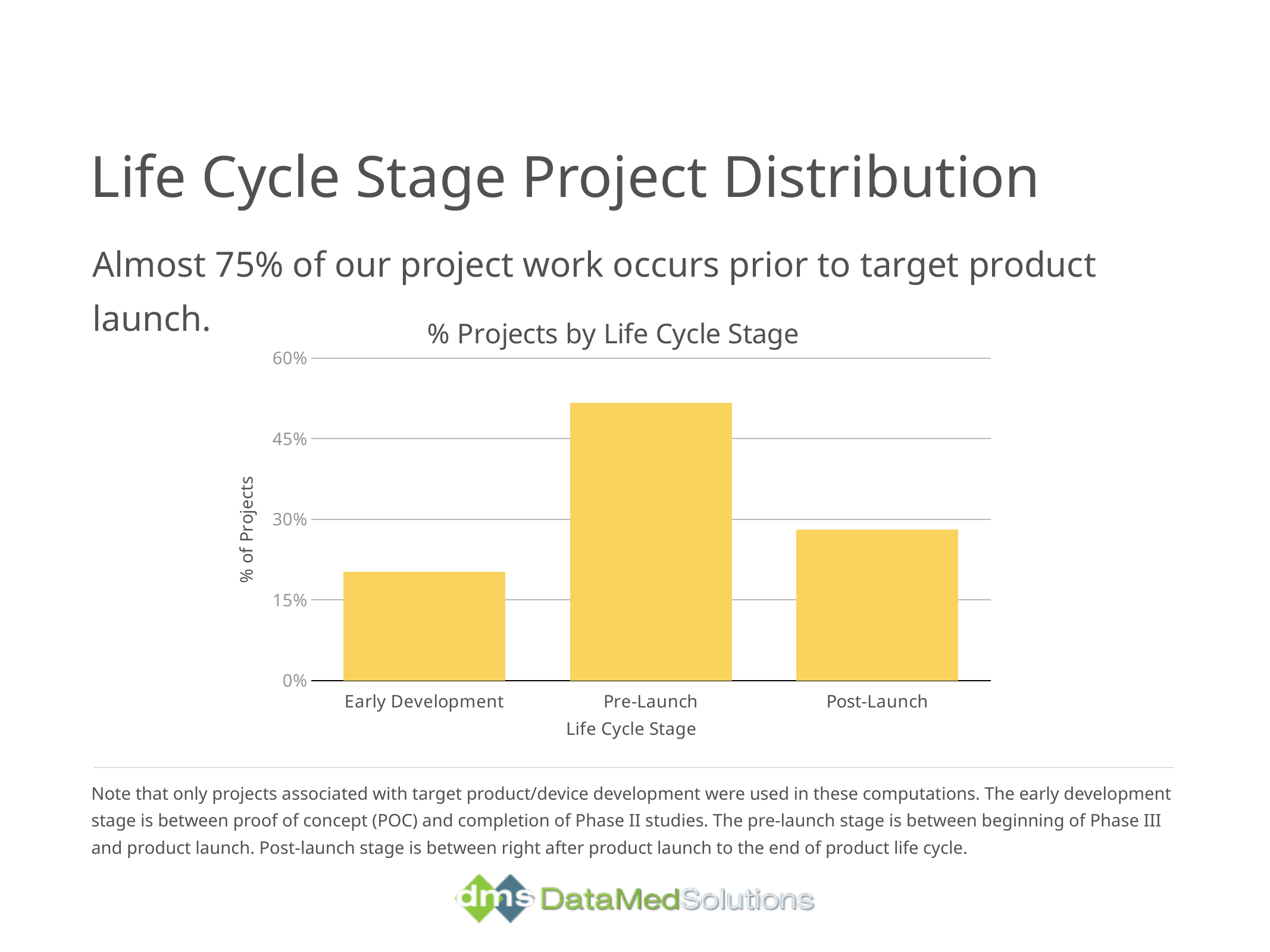
Which has a higher percentage of projects, Pre-Launch or Post-Launch? Pre-Launch Is the value for Early Development greater or less than 15%? greater Is the value for Early Development greater or less than 30%? less Which life cycle stage has the highest percentage of projects? Pre-Launch What is the label of the vertical axis of the chart? % of Projects What kind of chart is shown on the slide? bar chart Is the value for Pre-Launch greater or less than 45%? greater How many life cycle stages are plotted in the chart? 3 Which life cycle stage has the lowest percentage of projects? Early Development Which has a higher percentage of projects, Post-Launch or Early Development? Post-Launch What is the title of the chart? % Projects by Life Cycle Stage